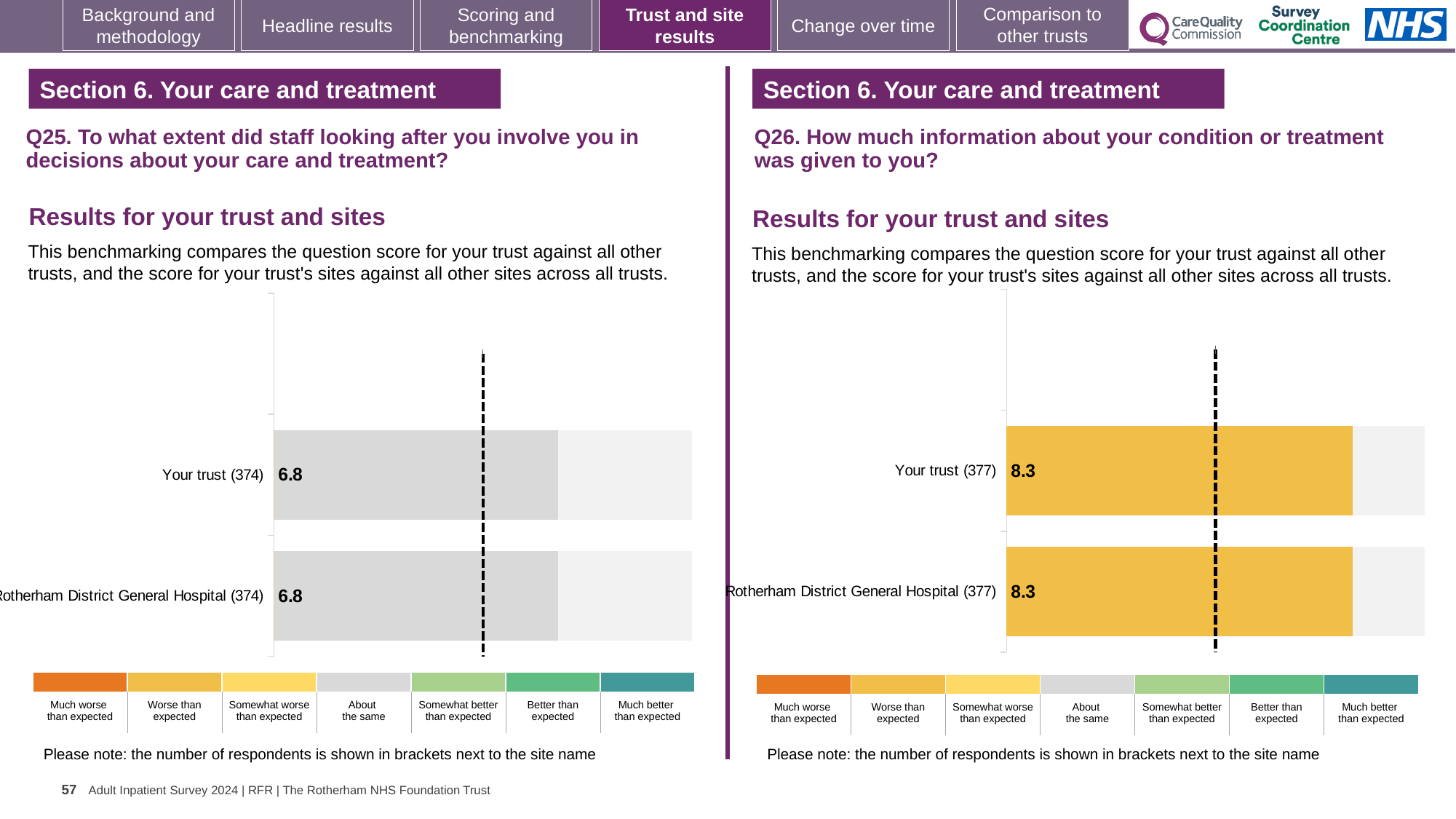
On the Q25 chart (left), what is the difference between the score for Your trust and the score for Rotherham District General Hospital? 0 On the Q26 chart (right), what is the score for Your trust? 8.3 On the Q26 chart (right), what is the score for Rotherham District General Hospital? 8.3 How many benchmark categories does the colour key below the Q25 chart (left) list? 7 What kind of chart is used for the Q26 results (right)? Bar chart On the Q25 chart (left), what is the score for Rotherham District General Hospital? 6.8 On the Q25 chart (left), what is the score for Your trust? 6.8 How many bars are plotted on the Q25 chart (left)? 2 How many bars are plotted on the Q26 chart (right)? 2 On the Q26 chart (right), how many respondents are shown in brackets for Rotherham District General Hospital? 377 On the Q26 chart (right), what is the difference between the score for Your trust and the score for Rotherham District General Hospital? 0 On the Q25 chart (left), how many respondents are shown in brackets for Your trust? 374